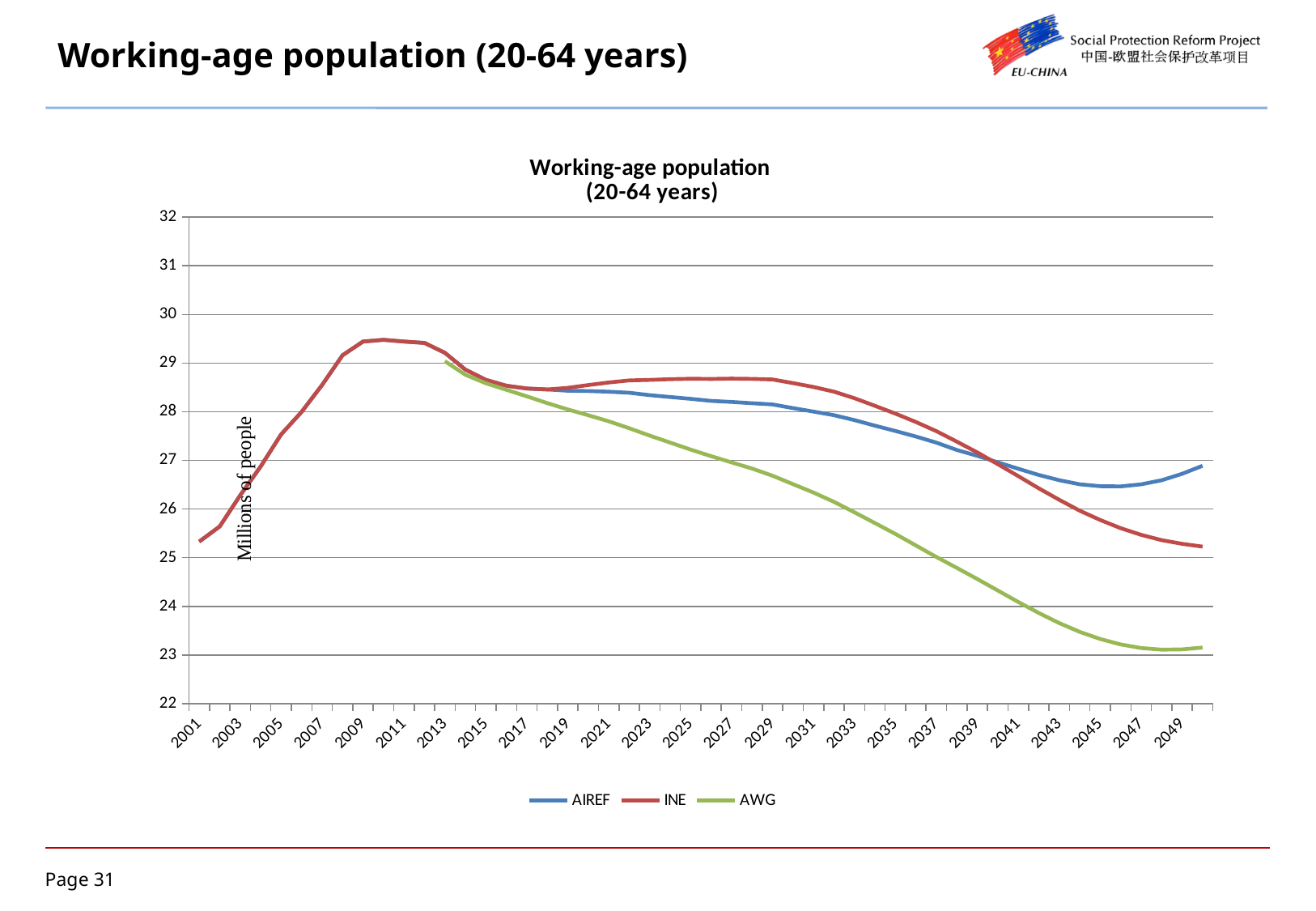
Is the value for INE in 2049 greater or less than 26? less How many series does the legend list? 3 Is the value for AWG in 2049 greater or less than 24? less In 2035, which is larger, the value for INE or the value for AIREF? INE Is the value for INE in 2025 greater or less than 28? greater What is the label on the vertical axis of the chart? Millions of people Which series is shown in green in the legend? AWG Which series has the lowest value in 2049? AWG Does the AWG series rise or fall from 2013 to 2049? fall Which series has the highest value in 2049? AIREF What kind of chart is shown on the slide? line chart